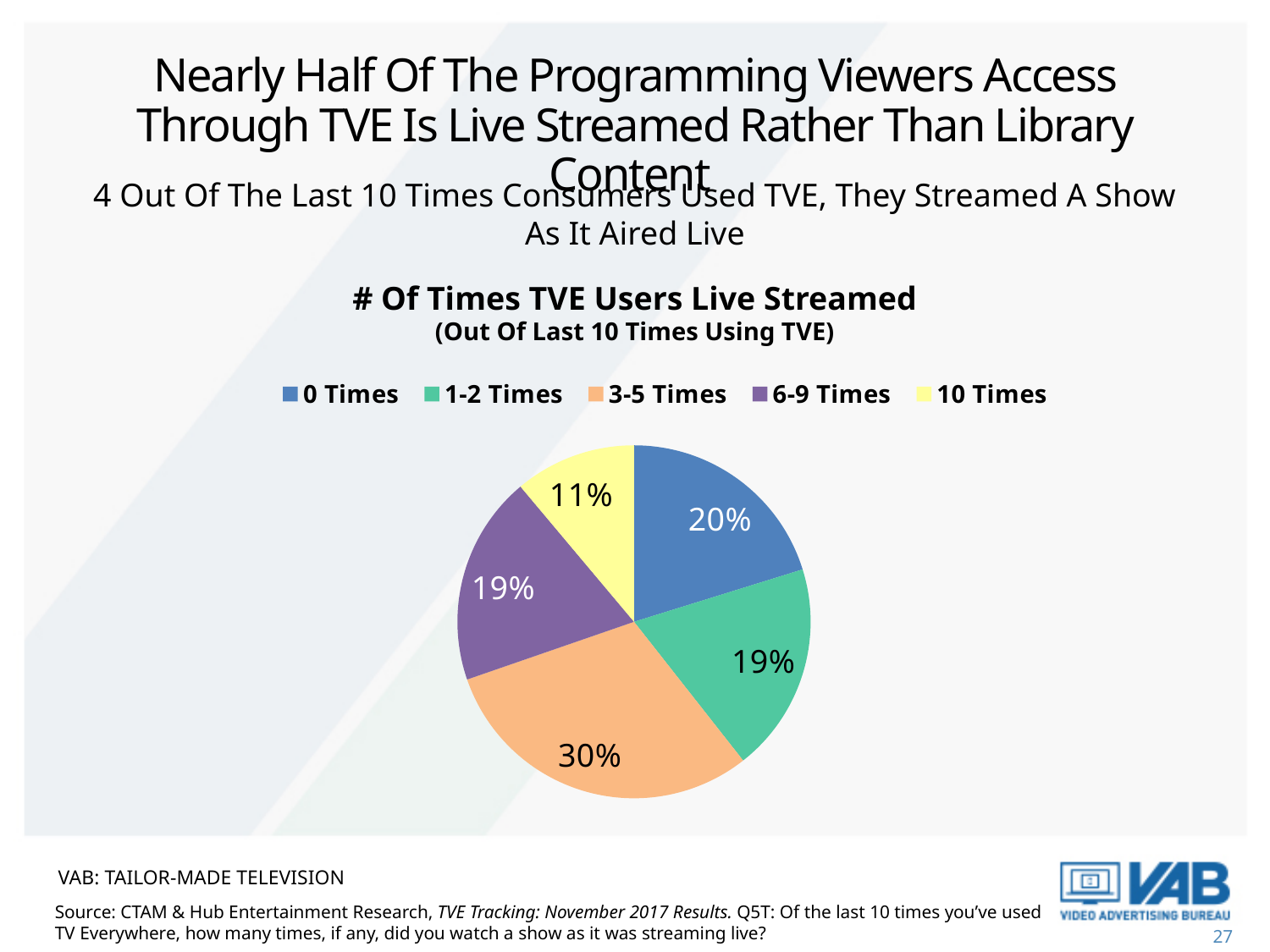
What percentage of TVE users live streamed 0 times? 20% What colour is the slice for 3-5 Times? orange Which category has the smallest share of the pie? 10 Times Which is larger, the share for 0 Times or the share for 10 Times? 0 Times What is the difference between the share for 3-5 Times and the share for 0 Times? 10% Which category has the largest share of the pie? 3-5 Times How many categories does the legend list? 5 What percentage of TVE users live streamed 10 times? 11% What is the title of the chart? # Of Times TVE Users Live Streamed (Out Of Last 10 Times Using TVE) What percentage of TVE users live streamed 3-5 times? 30% What percentage of TVE users live streamed 6-9 times? 19% What type of chart is shown on the slide? pie chart